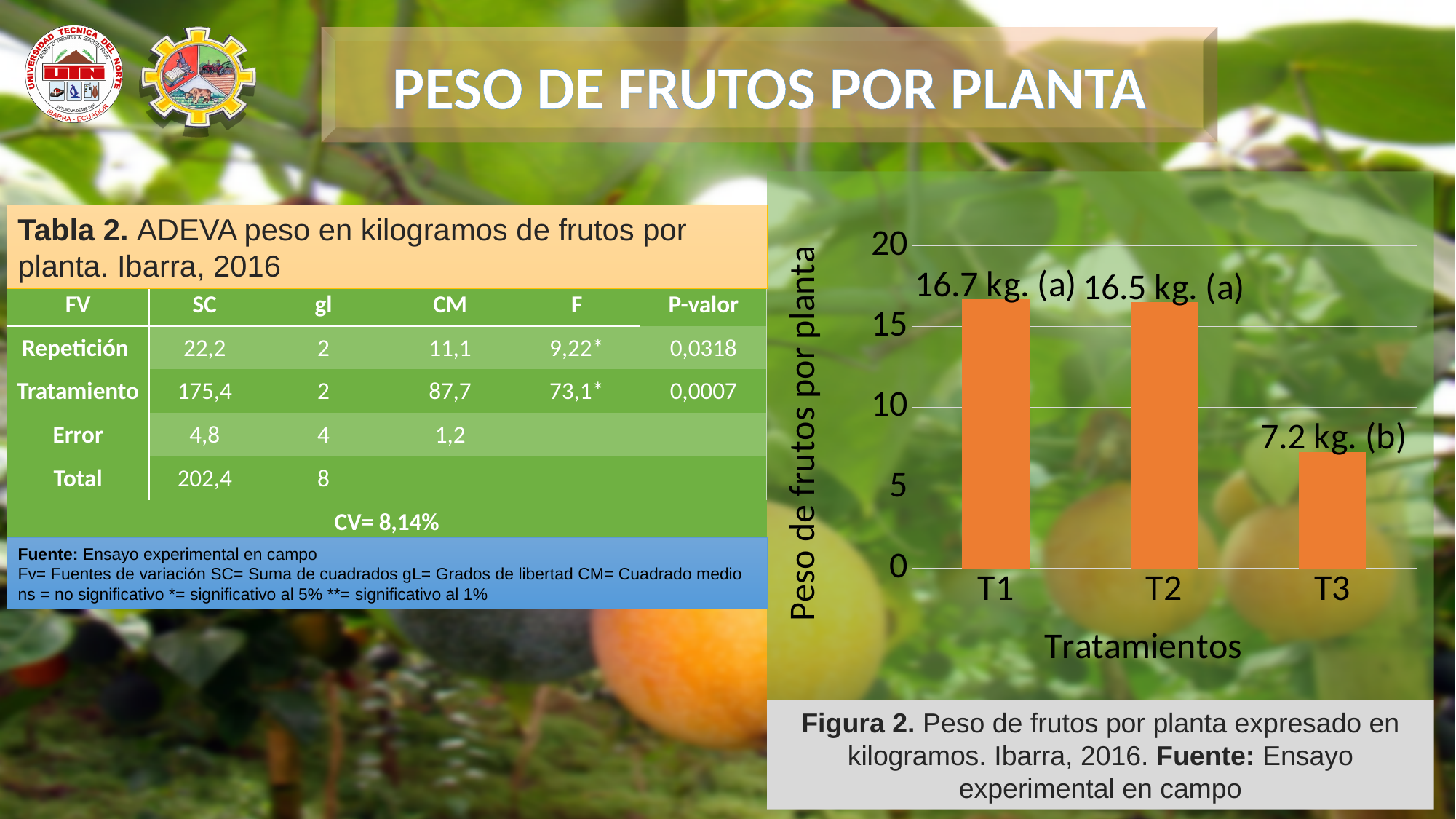
What is the label of the x axis of the bar chart? Tratamientos What is the difference between the values for T1 and T3 in the bar chart? 9.5 kg. What is the difference between the values for T2 and T3 in the bar chart? 9.3 kg. What is the value shown for T1 in the bar chart? 16.7 kg. What is the value shown for T3 in the bar chart? 7.2 kg. Is the value for T3 in the bar chart greater or less than 10? less How many treatments are plotted in the bar chart? 3 Which treatment has the lowest fruit weight per plant in the bar chart? T3 Which treatment has the highest fruit weight per plant according to the data labels in the bar chart? T1 What kind of chart is shown on the right side of the slide? bar chart Which is larger in the bar chart, the value for T2 or the value for T3? T2 What is the value shown for T2 in the bar chart? 16.5 kg.